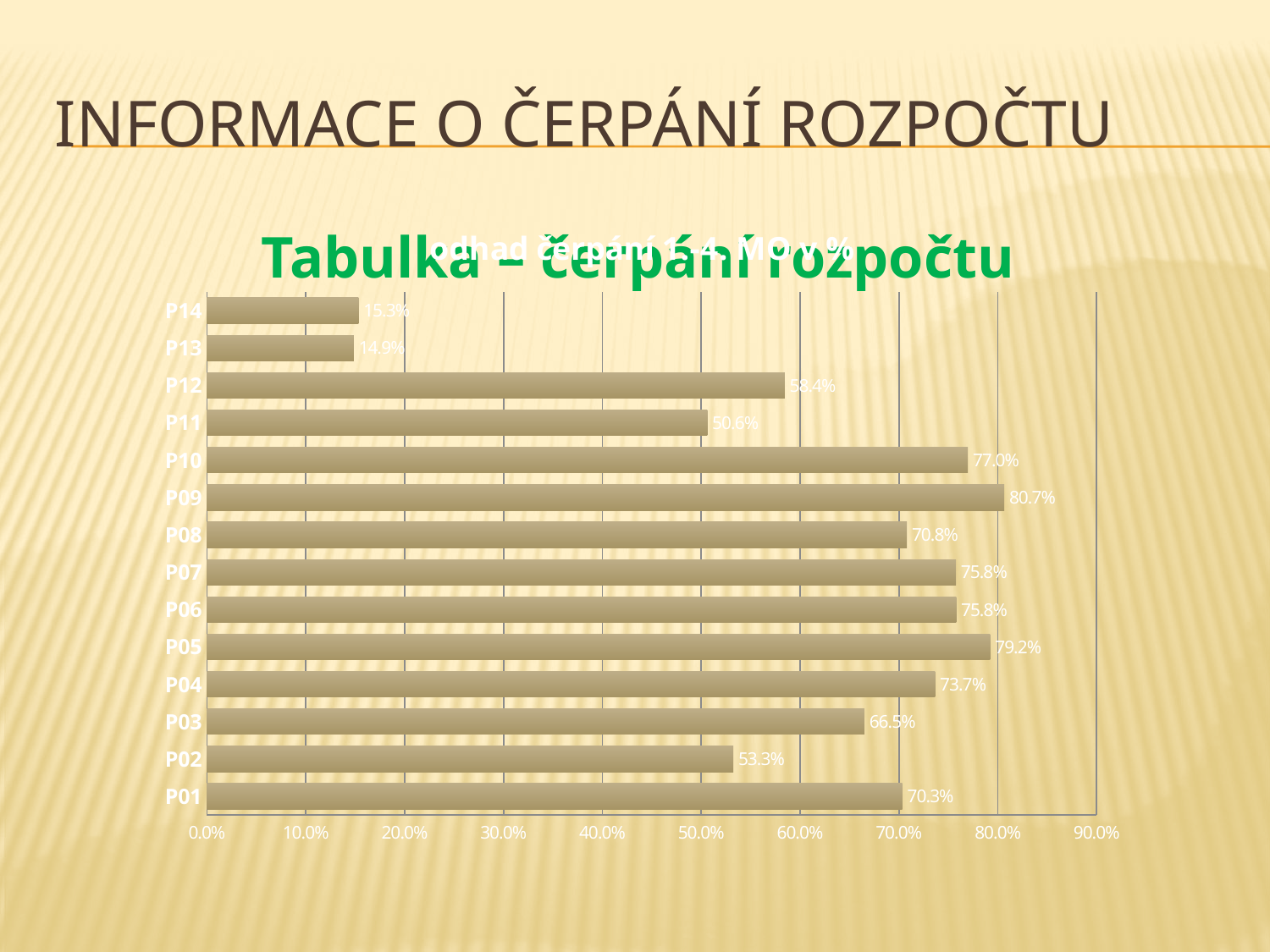
What is the value for P02? 53.3% What is the value for P05? 79.2% Which is larger, the value for P04 or the value for P03? P04 Is the value for P12 greater or less than 50%? greater Which category has the lowest value? P13 What is the value for P13? 14.9% What kind of chart is shown on the slide? bar chart How many categories are shown on the chart? 14 What is the value for P09? 80.7% What is the difference between the values for P09 and P13? 65.8% What is the difference between the values for P05 and P02? 25.9% Which category has the highest value? P09